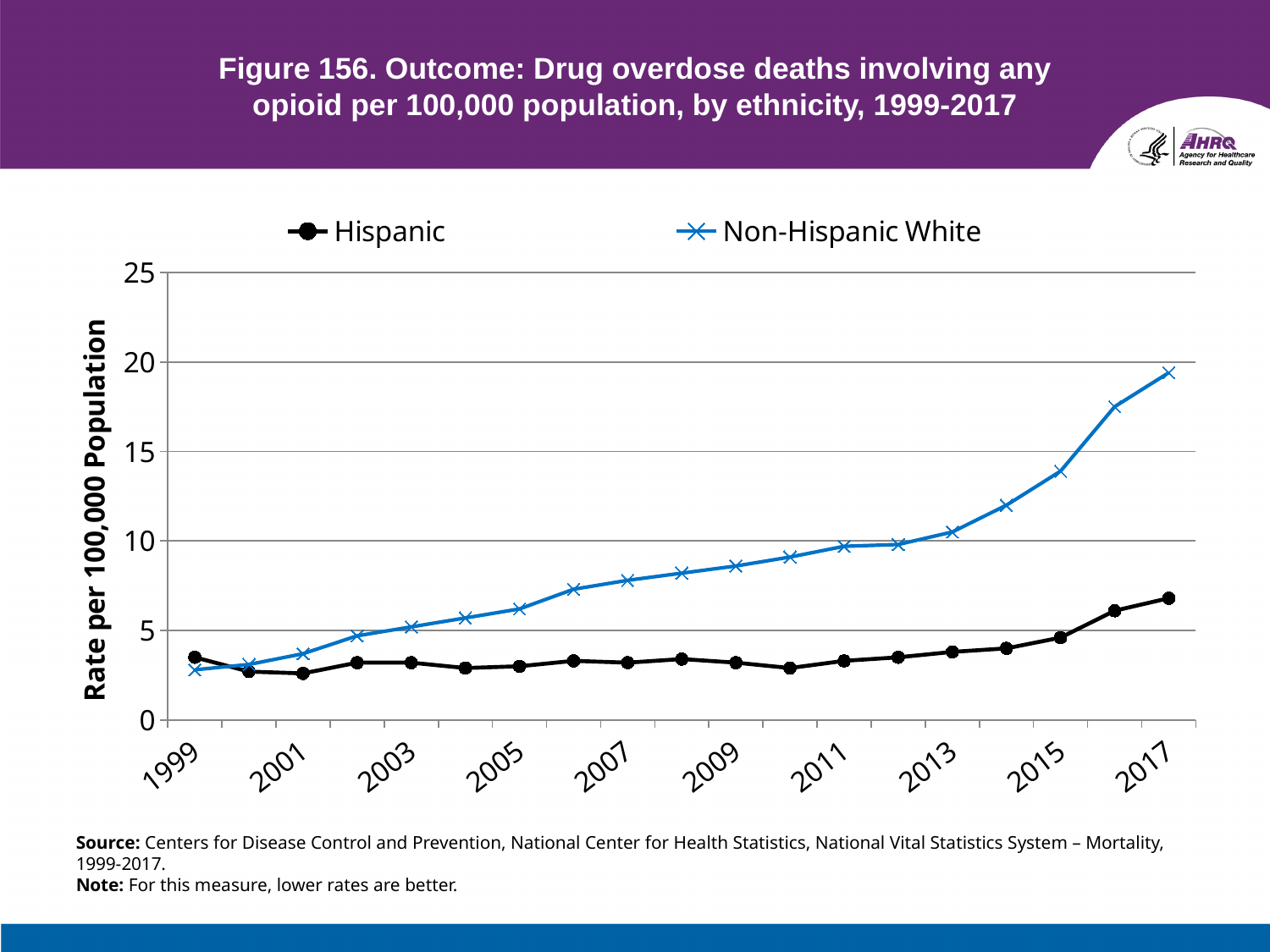
How many years of data points are plotted for each series? 19 What kind of chart is shown on the slide? Line chart How many series does the legend list? 2 Is the Non-Hispanic White rate in 2017 greater or less than 15? greater In which year is the Non-Hispanic White rate highest? 2017 Does the Non-Hispanic White rate rise or fall from 1999 to 2017? Rise In 2017, which series has the higher rate, Hispanic or Non-Hispanic White? Non-Hispanic White Is the Hispanic rate in 2017 greater or less than 10? less Which two series are shown in the legend? Hispanic and Non-Hispanic White What is the label on the vertical axis? Rate per 100,000 Population In which year is the Non-Hispanic White rate lowest? 1999 In which year is the Hispanic rate highest? 2017